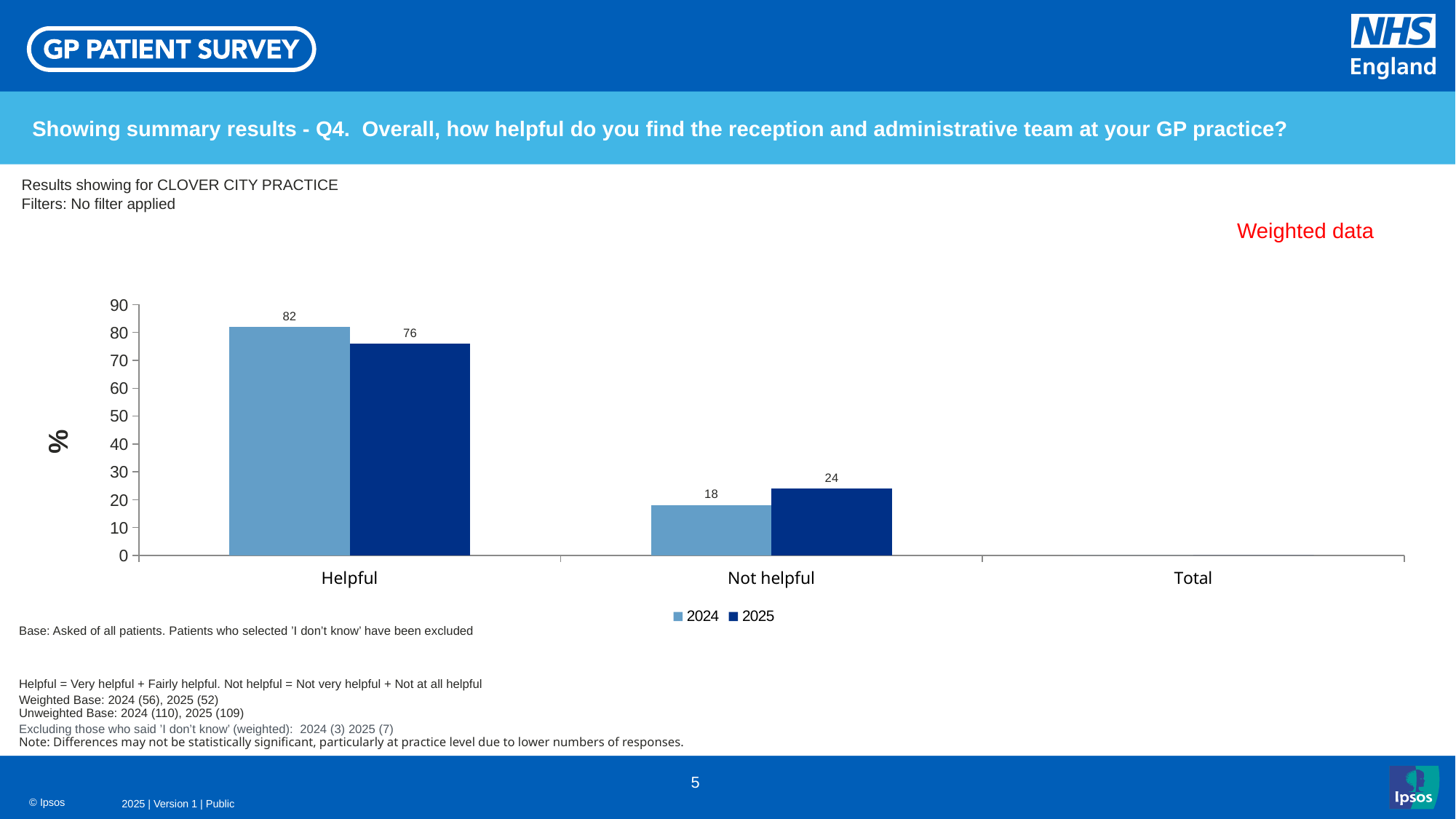
Which category has the lowest value in the 2024 series? Not helpful How many series does the legend list? 2 What is the difference between the 2024 and 2025 values for Helpful? 6 What is the value for Helpful in 2025? 76 What label is shown on the vertical axis of the chart? % Which is larger for Not helpful: the 2024 value or the 2025 value? 2025 What is the value for Not helpful in 2025? 24 What is the value for Not helpful in 2024? 18 What is the value for Helpful in 2024? 82 Which category has the highest value in the 2025 series? Helpful What kind of chart is shown on the slide? Bar chart Is the 2025 value for Helpful greater or less than 70? greater